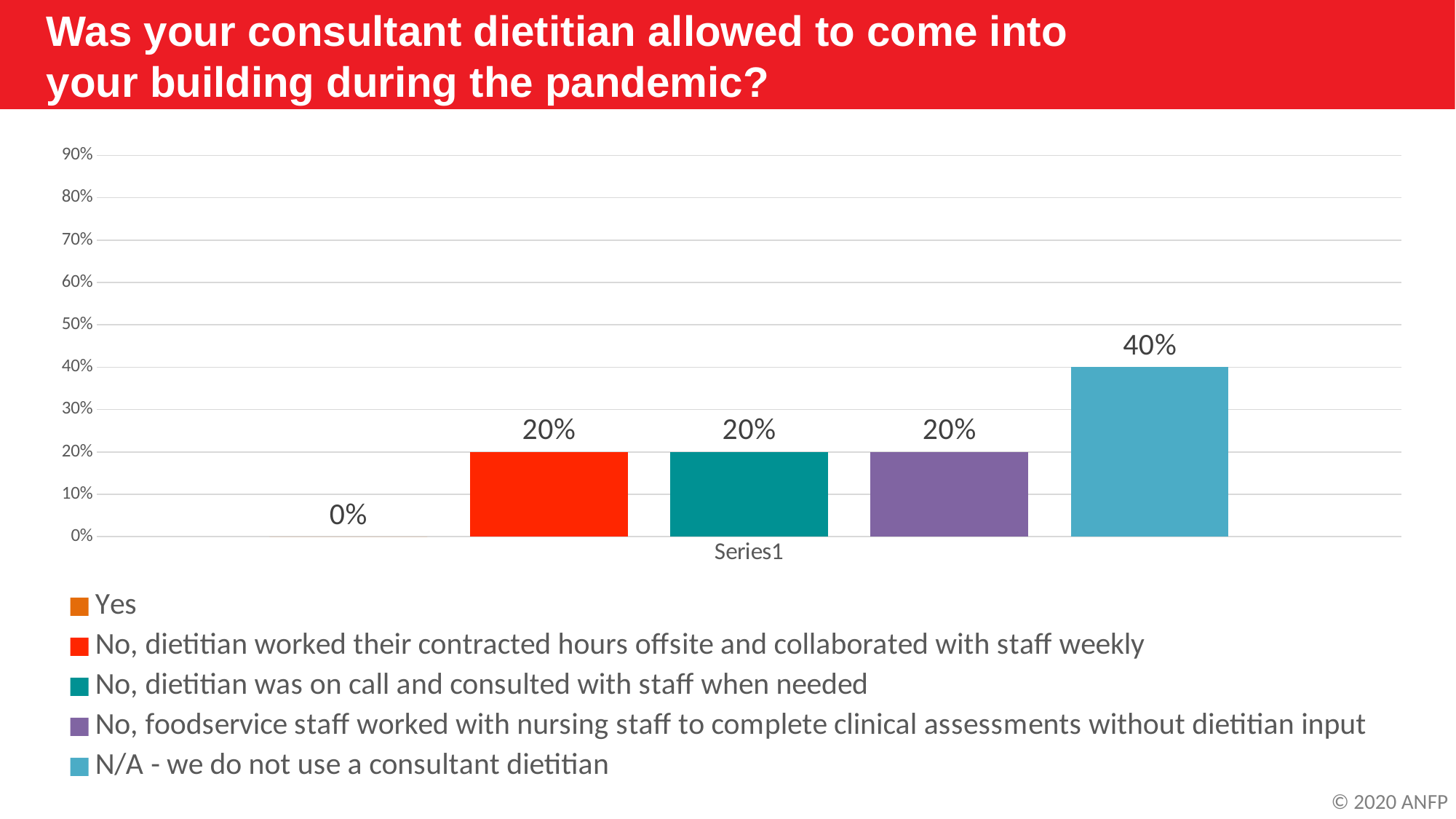
How many response options are listed in the legend? 5 Which response option has the highest percentage? N/A - we do not use a consultant dietitian Which is larger: the percentage for "N/A - we do not use a consultant dietitian" or the percentage for "No, foodservice staff worked with nursing staff to complete clinical assessments without dietitian input"? N/A - we do not use a consultant dietitian How many response options share the value 20%? 3 What percentage of respondents answered "No, dietitian was on call and consulted with staff when needed"? 20% What percentage of respondents answered "N/A - we do not use a consultant dietitian"? 40% What kind of chart is shown on the slide? bar chart What is the title of the slide? Was your consultant dietitian allowed to come into your building during the pandemic? What is the difference between the percentage for "N/A - we do not use a consultant dietitian" and the percentage for "No, dietitian worked their contracted hours offsite and collaborated with staff weekly"? 20% Is the value for "N/A - we do not use a consultant dietitian" greater or less than 30%? greater What percentage of respondents answered "Yes"? 0% Which response option has the lowest percentage? Yes